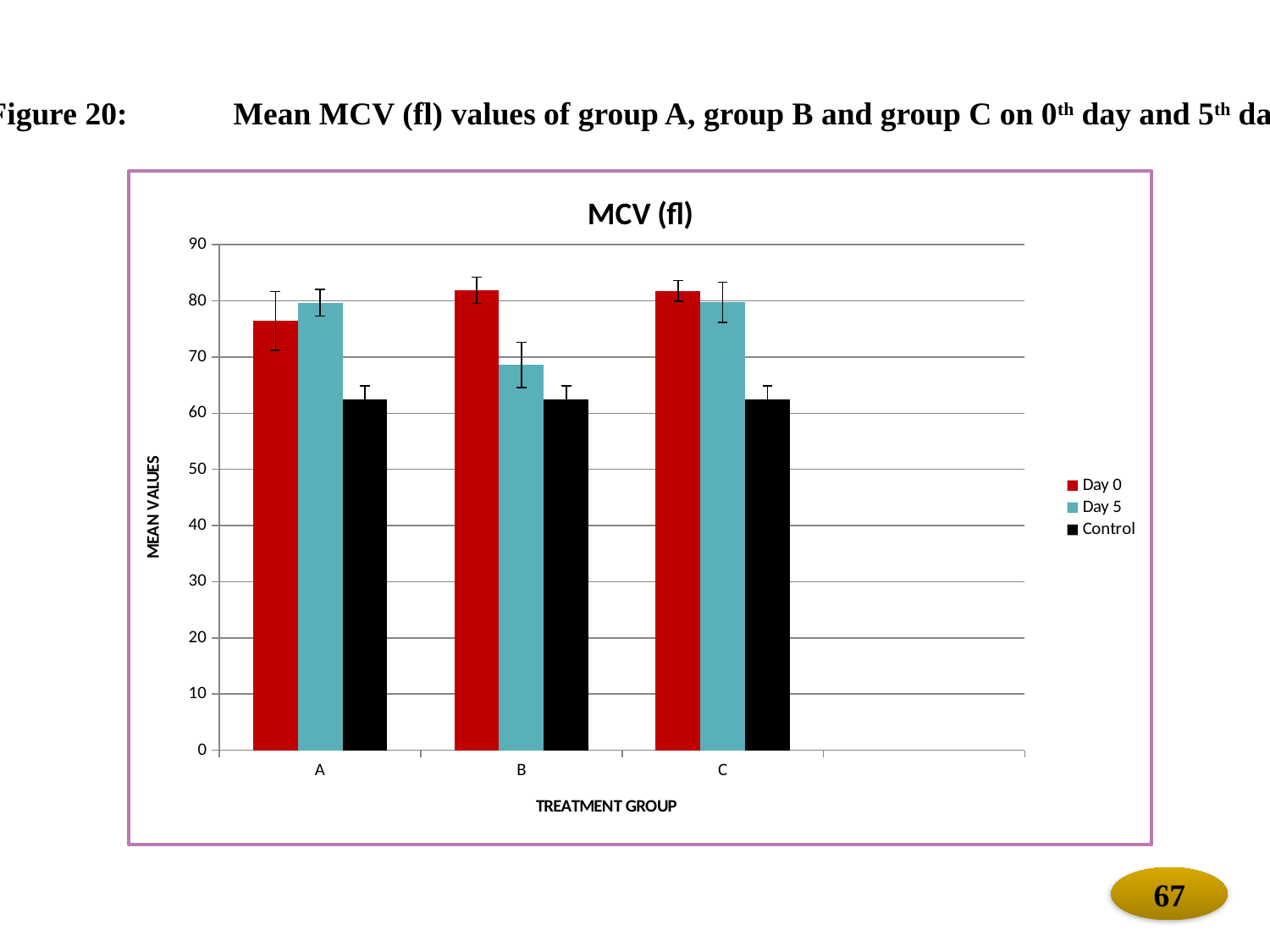
For group B, which is larger, the Day 0 value or the Day 5 value? Day 0 Is the Day 5 value for group A greater or less than 70? greater Is the Control value for group A greater or less than 70? less Which treatment group has the lowest Day 0 value? A What is the title of the chart? MCV (fl) How many series does the legend list? 3 What kind of chart is shown on the slide? bar chart Is the Day 5 value for group B greater or less than 60? greater Which treatment group has the lowest Day 5 value? B How many treatment groups are shown on the x axis? 3 What is the label of the y axis? MEAN VALUES